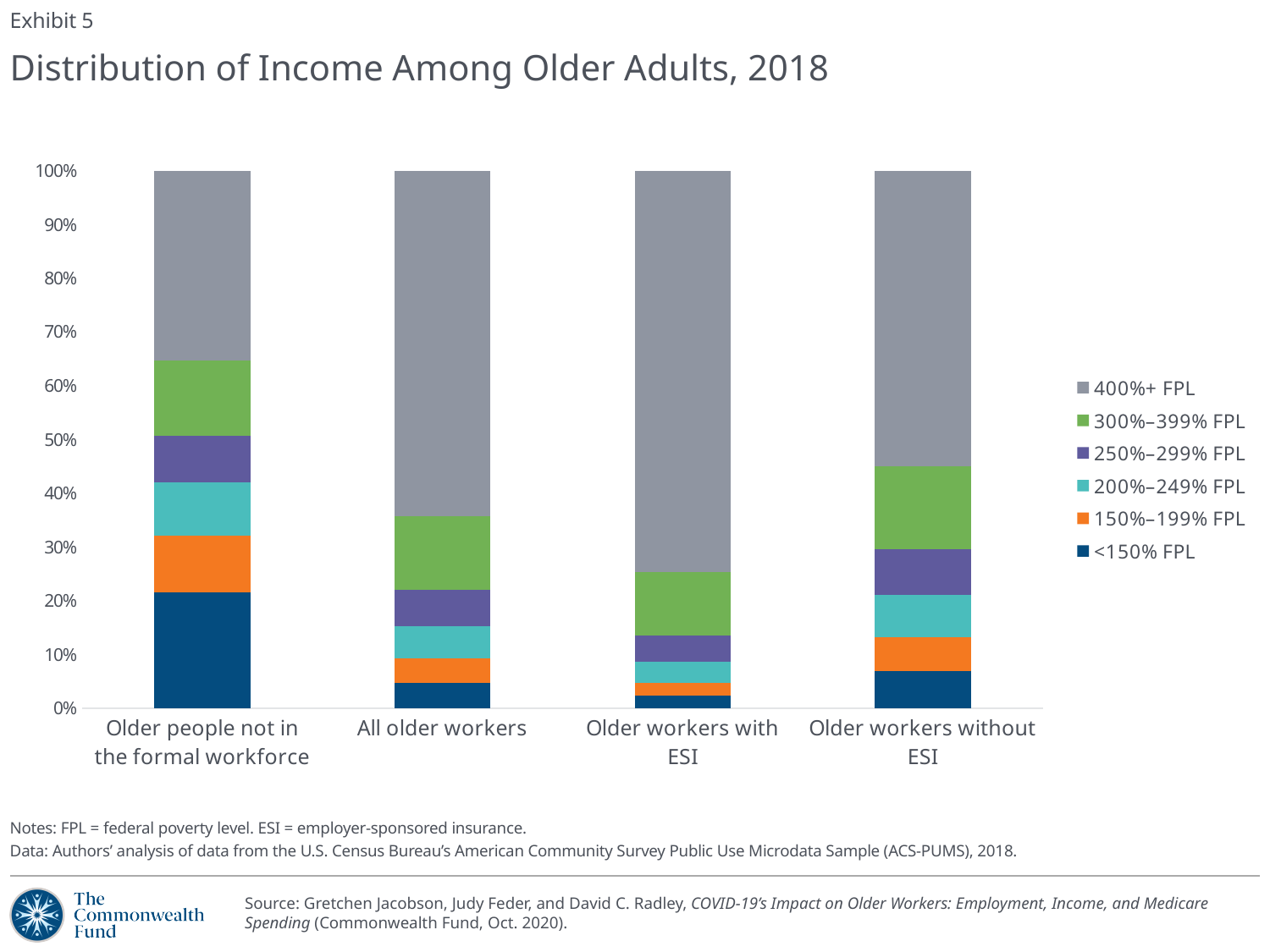
Which category has the smallest <150% FPL share? Older workers with ESI Is the <150% FPL share for Older workers with ESI greater or less than 10%? less How many series does the legend list? 6 Which category has the largest <150% FPL share? Older people not in the formal workforce What is the title of the chart? Distribution of Income Among Older Adults, 2018 What is the total of the stacked bar for All older workers? 100% Which category has the smallest 400%+ FPL share? Older people not in the formal workforce Is the <150% FPL share for Older people not in the formal workforce greater or less than 20%? greater Which category has the largest 400%+ FPL share? Older workers with ESI What kind of chart is shown on the slide? Bar chart How many categories are shown along the x axis? 4 Which has a larger 400%+ FPL share: All older workers or Older workers without ESI? All older workers